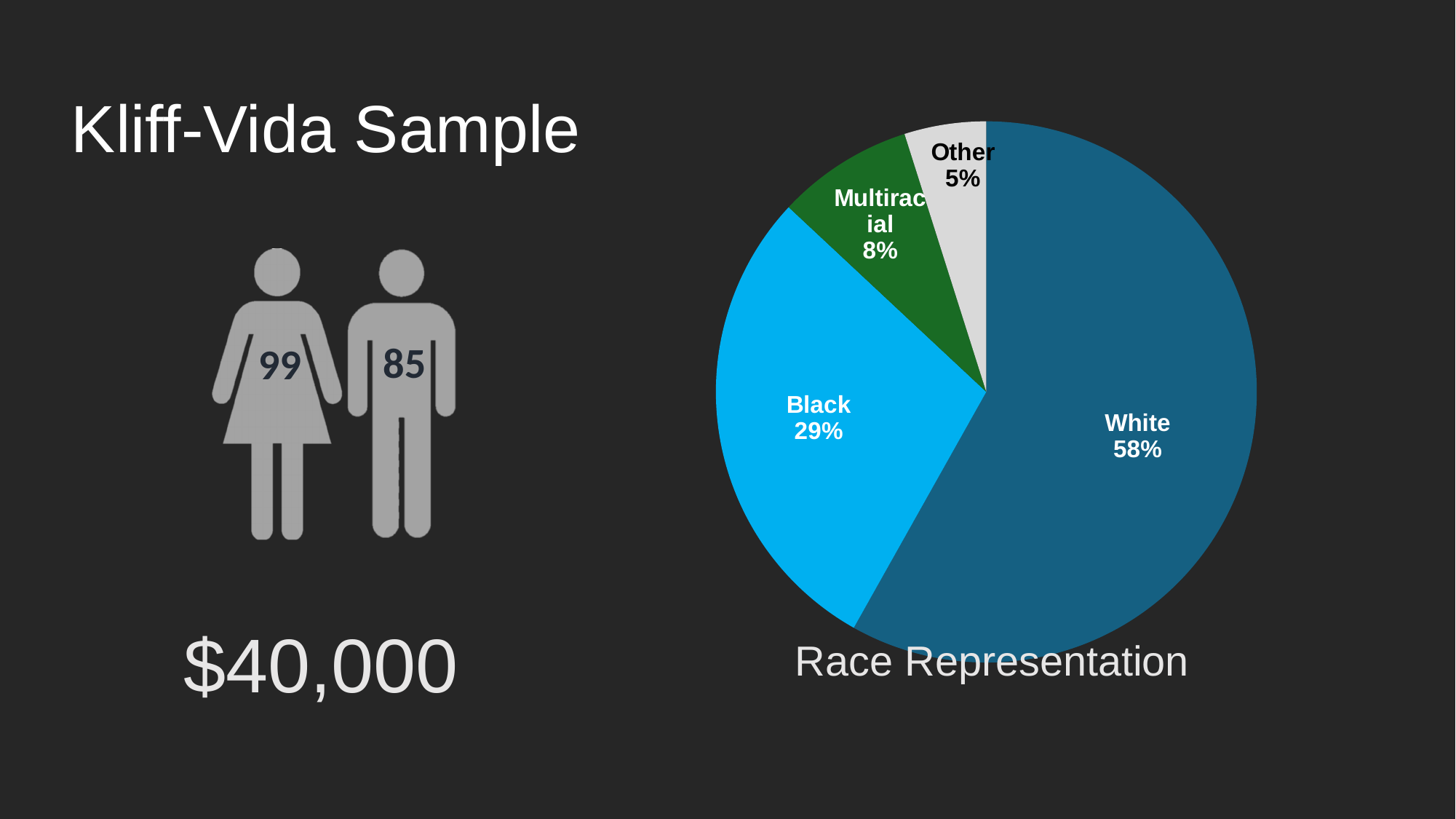
In the Race Representation pie chart, which is larger, Multiracial or Other? Multiracial What share of the Race Representation pie is Black? 29% What share of the Race Representation pie is Other? 5% In the Race Representation pie chart, what is the difference between the Multiracial and Other shares? 3% Which category has the largest slice in the Race Representation pie chart? White What share of the Race Representation pie is White? 58% In the Race Representation pie chart, what is the difference between the White and Black shares? 29% How many slices does the Race Representation pie chart have? 4 Which category has the smallest slice in the Race Representation pie chart? Other What type of chart is the Race Representation chart? pie chart What is the title shown below the pie chart? Race Representation